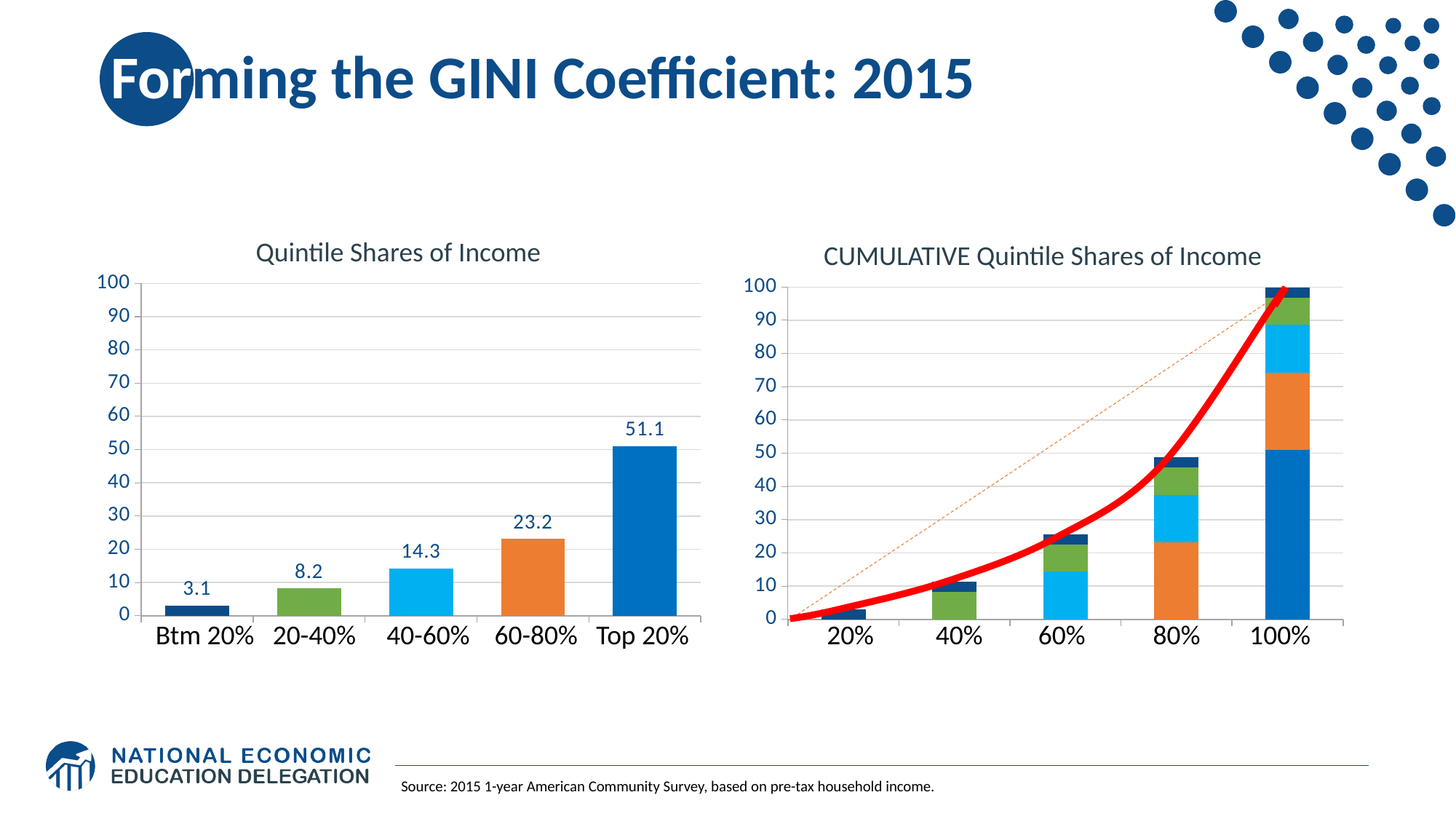
In the 'CUMULATIVE Quintile Shares of Income' chart, is the total of the stacked bar at 60% greater or less than 30? less In the 'Quintile Shares of Income' chart, which quintile has the highest share? Top 20% In the 'Quintile Shares of Income' chart, what is the difference between the Top 20% and the 60-80% values? 27.9 In the 'Quintile Shares of Income' chart, what is the value for Btm 20%? 3.1 In the 'Quintile Shares of Income' chart, which quintile has the lowest share? Btm 20% In the 'Quintile Shares of Income' chart, how many quintile categories are shown? 5 In the 'Quintile Shares of Income' chart, what is the value for the 40-60% quintile? 14.3 In the 'CUMULATIVE Quintile Shares of Income' chart, is the total of the stacked bar at 80% greater or less than 40? greater What kind of chart is the 'CUMULATIVE Quintile Shares of Income' chart? stacked bar chart In the 'Quintile Shares of Income' chart, which is larger, the value for 20-40% or the value for 40-60%? 40-60% In the 'Quintile Shares of Income' chart, what is the value for the Top 20%? 51.1 In the 'Quintile Shares of Income' chart, do the values rise or fall moving from Btm 20% to Top 20%? rise